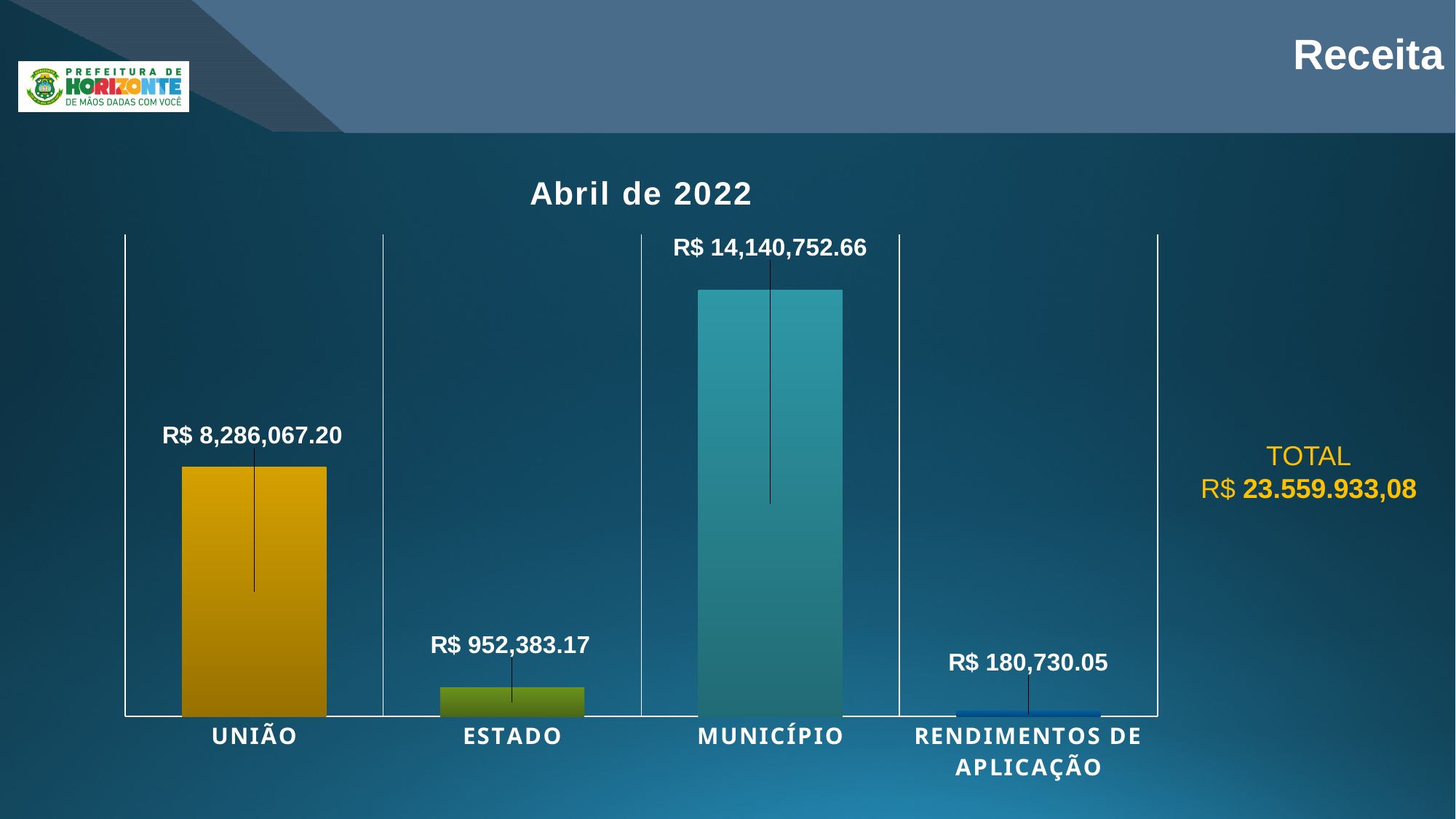
How many categories are shown in the chart? 4 Which category has the lowest value? RENDIMENTOS DE APLICAÇÃO What is the difference between the values for ESTADO and RENDIMENTOS DE APLICAÇÃO? R$ 771,653.12 Which is larger, the value for UNIÃO or the value for ESTADO? UNIÃO What is the value for MUNICÍPIO? R$ 14,140,752.66 Which category has the highest value? MUNICÍPIO What is the difference between the values for MUNICÍPIO and UNIÃO? R$ 5,854,685.46 What kind of chart is shown on the slide? Bar chart What is the value for RENDIMENTOS DE APLICAÇÃO? R$ 180,730.05 What is the value for ESTADO? R$ 952,383.17 What is the value for UNIÃO? R$ 8,286,067.20 What is the title of the chart? Abril de 2022